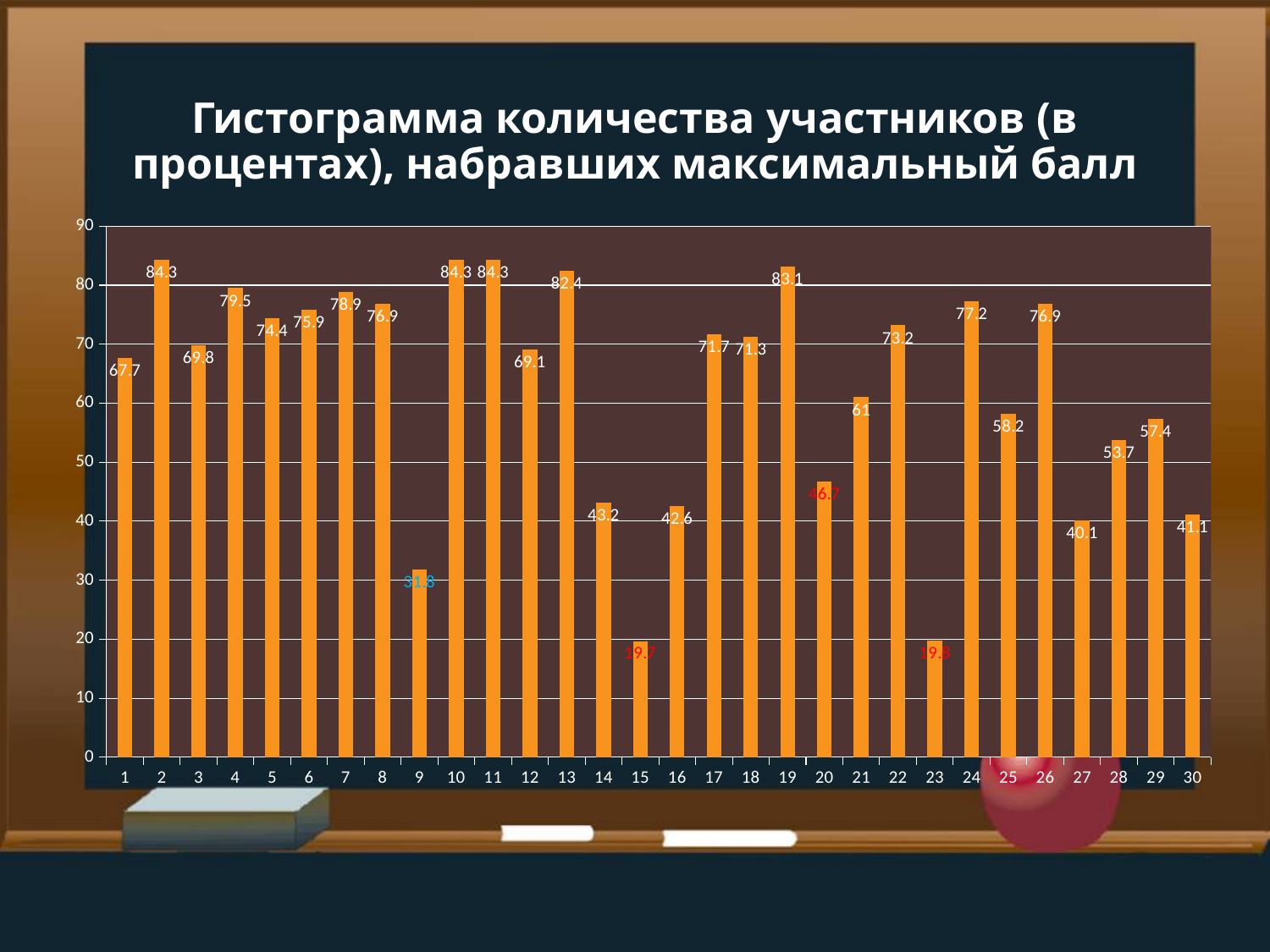
What is the value for category 21? 61 What is the value for category 19? 83.1 Which has a larger value, category 19 or category 20? category 19 How many categories are shown on the x axis? 30 What is the value for category 27? 40.1 What is the difference between the values for category 24 and category 25? 19 What is the highest value shown on the chart? 84.3 Which has a larger value, category 14 or category 16? category 14 What is the value for category 9? 31.8 What is the difference between the values for category 13 and category 12? 13.3 Is the value for category 15 greater or less than 30? less What kind of chart is shown on the slide? bar chart